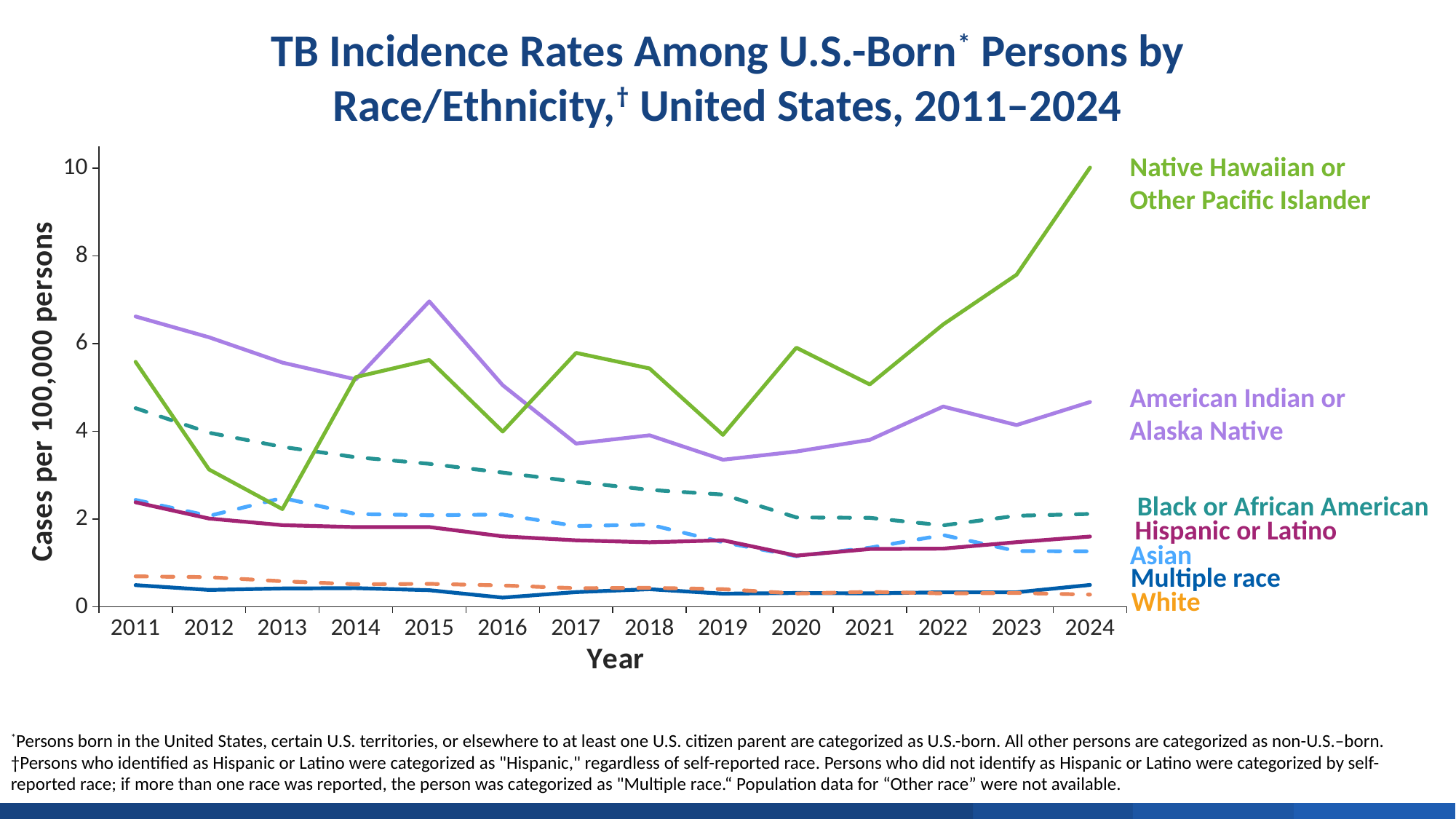
Which group has the highest TB incidence rate in 2024? Native Hawaiian or Other Pacific Islander How many years are shown along the x axis of the chart? 14 Which group has the highest TB incidence rate in 2011? American Indian or Alaska Native In 2015, which group has a higher TB incidence rate: American Indian or Alaska Native, or Native Hawaiian or Other Pacific Islander? American Indian or Alaska Native How many race/ethnicity groups are plotted as lines on the chart? 7 Is the TB incidence rate for Native Hawaiian or Other Pacific Islander persons in 2024 greater or less than 8? greater Is the TB incidence rate for Black or African American persons in 2011 greater or less than 4? greater Is the TB incidence rate for American Indian or Alaska Native persons in 2019 greater or less than 4? less What kind of chart is shown on the slide? line chart Which group has the lowest TB incidence rate in 2024? White Does the TB incidence rate for Black or African American persons generally rise or fall from 2011 to 2024? fall What is the label of the y axis on the chart? Cases per 100,000 persons